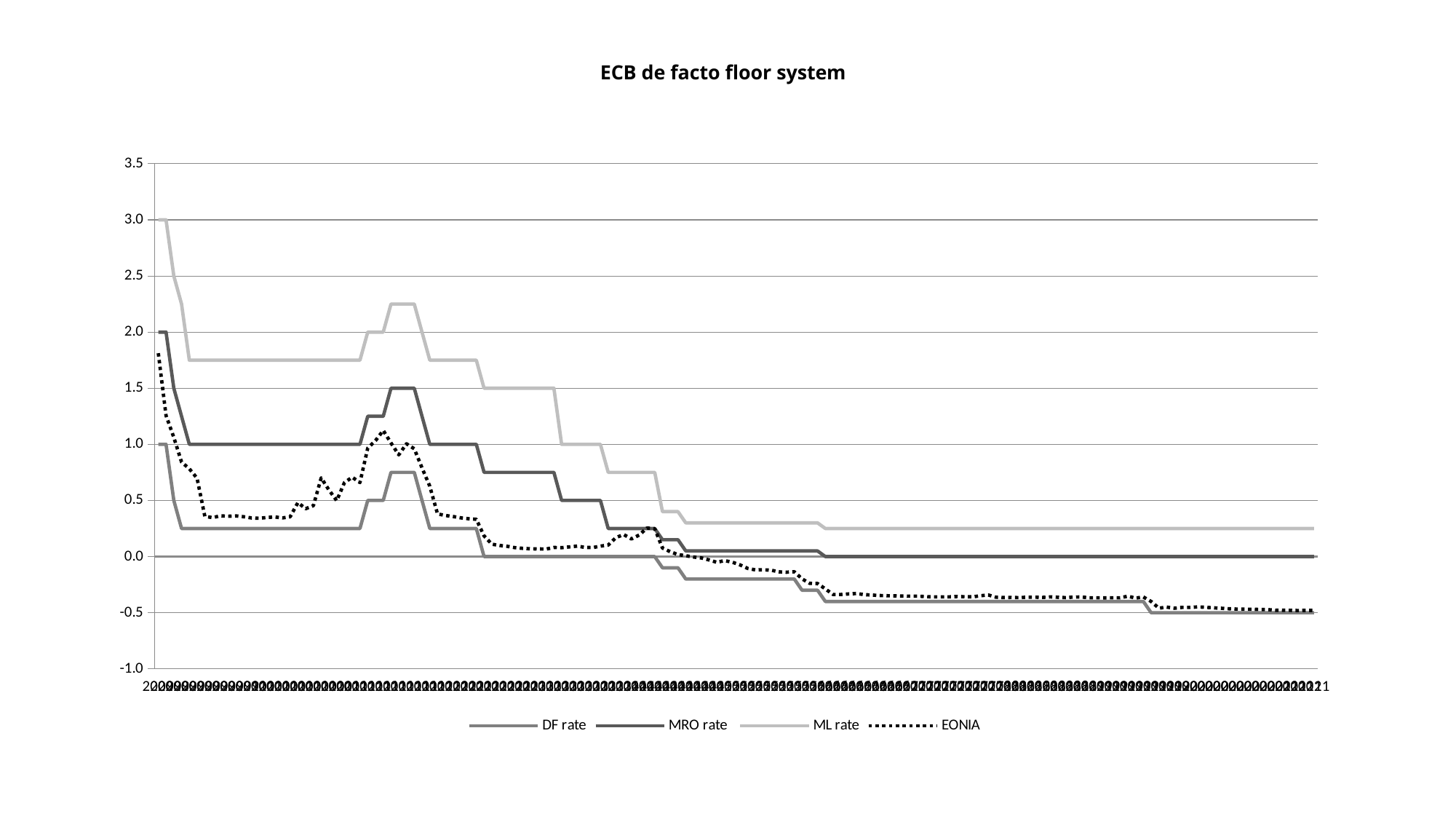
Is the value of the ML rate at the right end of the chart greater or less than 0.5? less What is the difference between the ML rate and the DF rate at the left end of the chart? 2.0 What is the value of the ML rate at the left end of the chart? 3.0 Which series is drawn with a dotted line? EONIA How many series does the legend list? 4 What is the value of the DF rate at the right end of the chart? -0.5 Which series has the highest value at the left end of the chart? ML rate What type of chart is shown on the slide? line chart What is the value of the DF rate at the left end of the chart? 1.0 What is the title of the chart? ECB de facto floor system Which series has the lowest value at the left end of the chart? DF rate What is the value of the MRO rate at the left end of the chart? 2.0